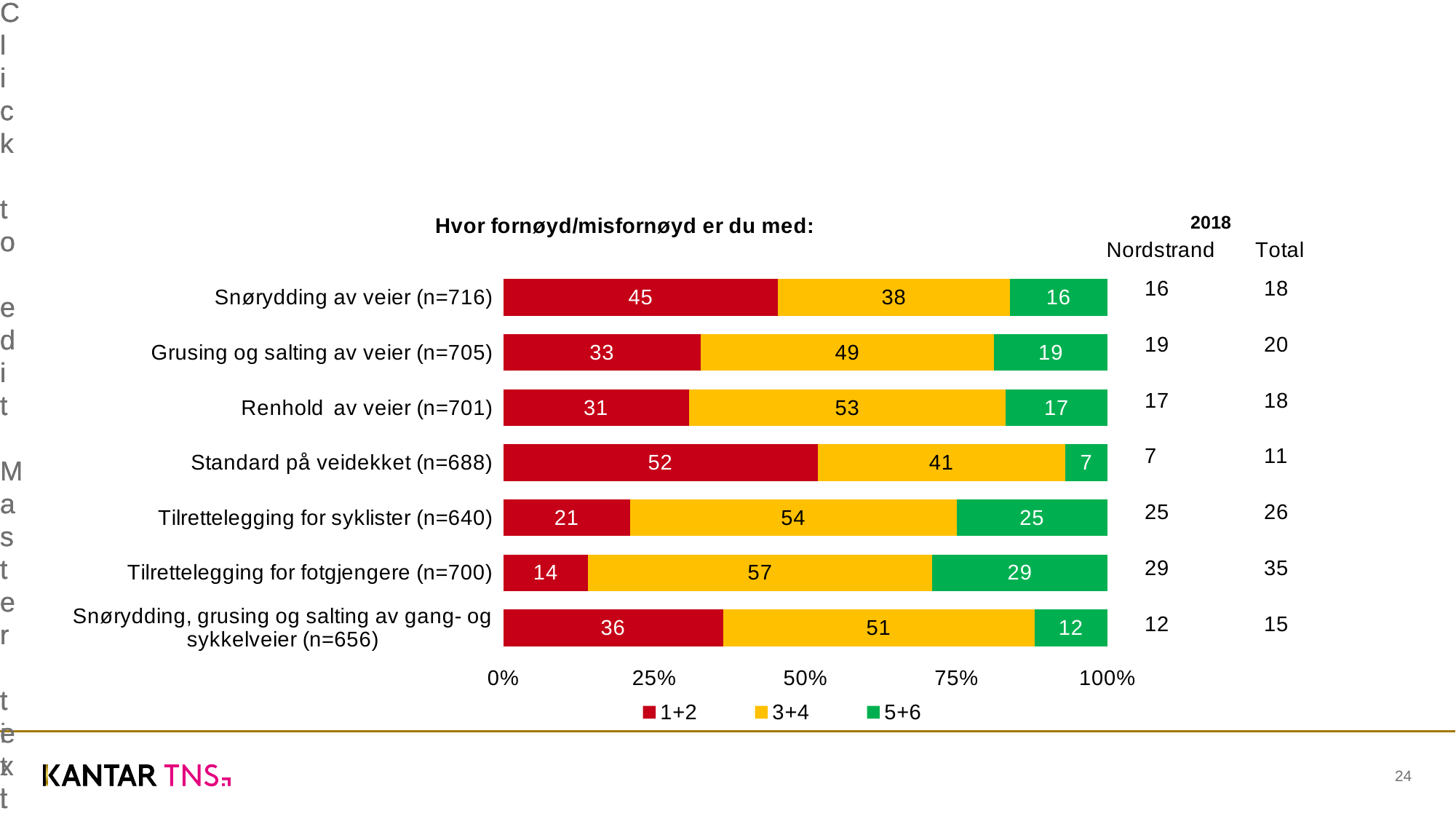
Which category has the highest value in the 1+2 series? Standard på veidekket (n=688) What is the value of the 3+4 series for Tilrettelegging for fotgjengere (n=700)? 57 How many categories are shown in the chart? 7 What kind of chart is shown on the slide? Stacked bar chart What is the title of the chart? Hvor fornøyd/misfornøyd er du med: What is the difference between the 3+4 values for Renhold av veier (n=701) and Snørydding av veier (n=716)? 15 Which category has the lowest value in the 5+6 series? Standard på veidekket (n=688) Which category has the highest value in the 5+6 series? Tilrettelegging for fotgjengere (n=700) How many series does the legend list? 3 What is the value of the 5+6 series for Standard på veidekket (n=688)? 7 Which is larger: the 1+2 value for Grusing og salting av veier (n=705) or the 1+2 value for Snørydding, grusing og salting av gang- og sykkelveier (n=656)? Snørydding, grusing og salting av gang- og sykkelveier (n=656) What is the value of the 1+2 series for Snørydding av veier (n=716)? 45